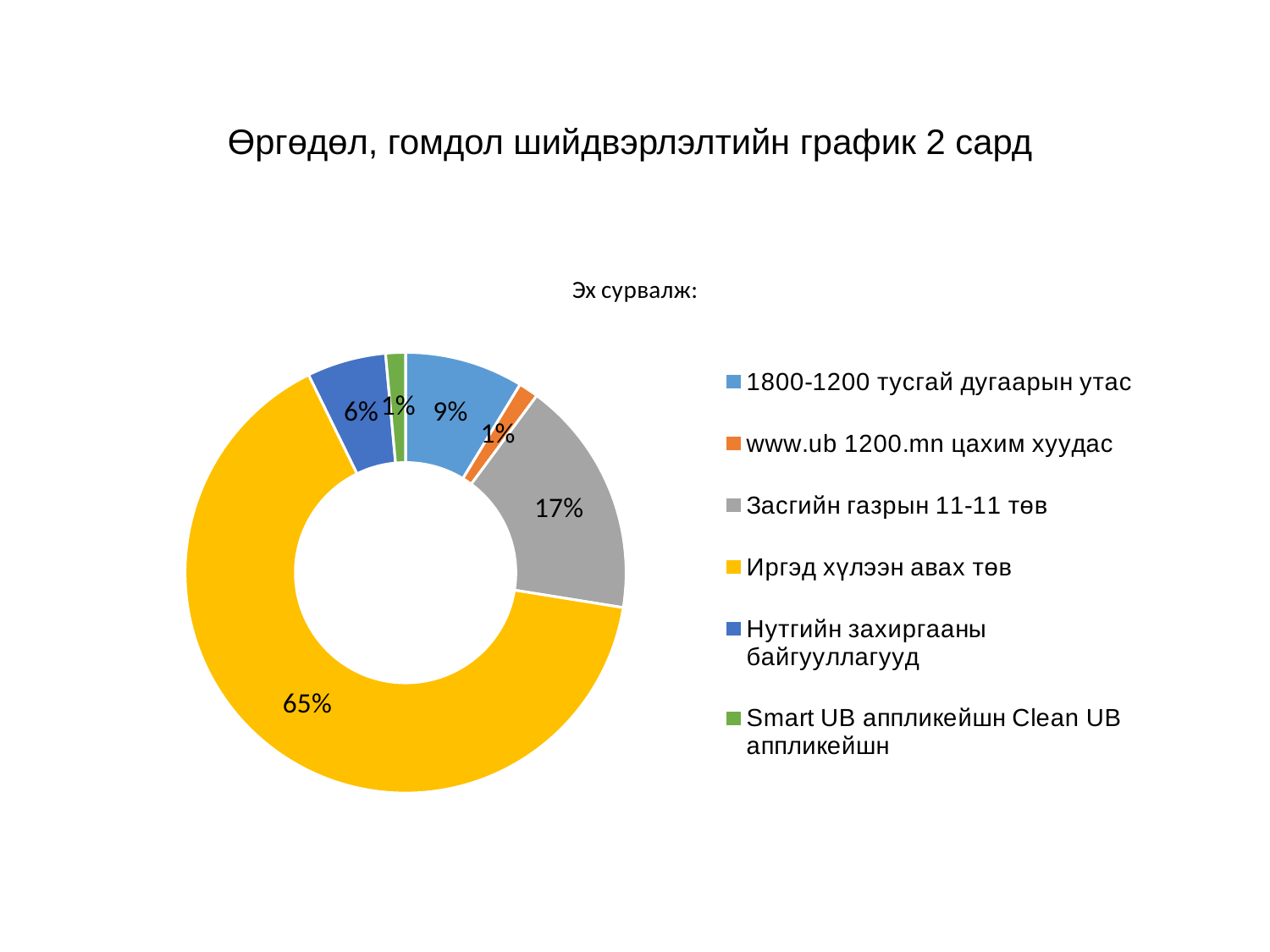
Which has a larger share: 1800-1200 тусгай дугаарын утас or Нутгийн захиргааны байгууллагууд? 1800-1200 тусгай дугаарын утас What share does www.ub 1200.mn цахим хуудас have in the chart? 1% What share does Иргэд хүлээн авах төв have in the chart? 65% What share does Нутгийн захиргааны байгууллагууд have in the chart? 6% Which category has the largest share in the chart? Иргэд хүлээн авах төв What is the title of the chart? Эх сурвалж: How many categories does the chart show? 6 What is the difference in percentage points between Иргэд хүлээн авах төв and Засгийн газрын 11-11 төв? 48 What kind of chart is shown on the slide? Doughnut chart What colour represents Засгийн газрын 11-11 төв in the chart? Grey